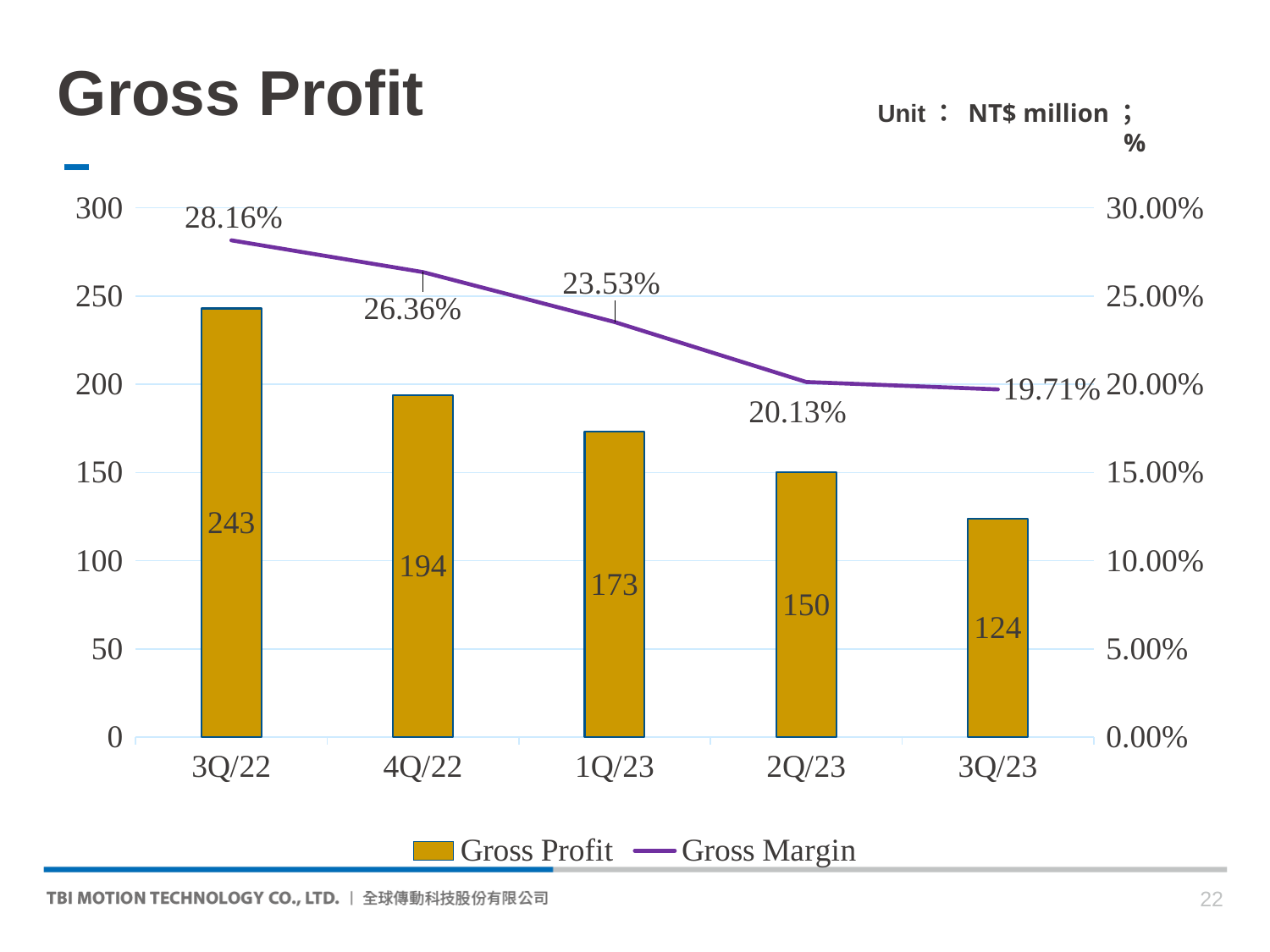
Which is larger, the Gross Profit for 4Q/22 or for 2Q/23? 4Q/22 Does the Gross Margin rise or fall from 3Q/22 to 3Q/23? fall Is the Gross Profit for 2Q/23 greater or less than 100? greater Which quarter has the highest Gross Profit? 3Q/22 What is the Gross Profit for 1Q/23? 173 How many quarters are shown on the x axis? 5 What colour are the Gross Profit bars? gold How many series does the legend list? 2 What is the difference in Gross Profit between 3Q/22 and 3Q/23? 119 What is the Gross Margin for 2Q/23? 20.13% What is the Gross Profit for 3Q/22? 243 Which quarter has the lowest Gross Margin? 3Q/23